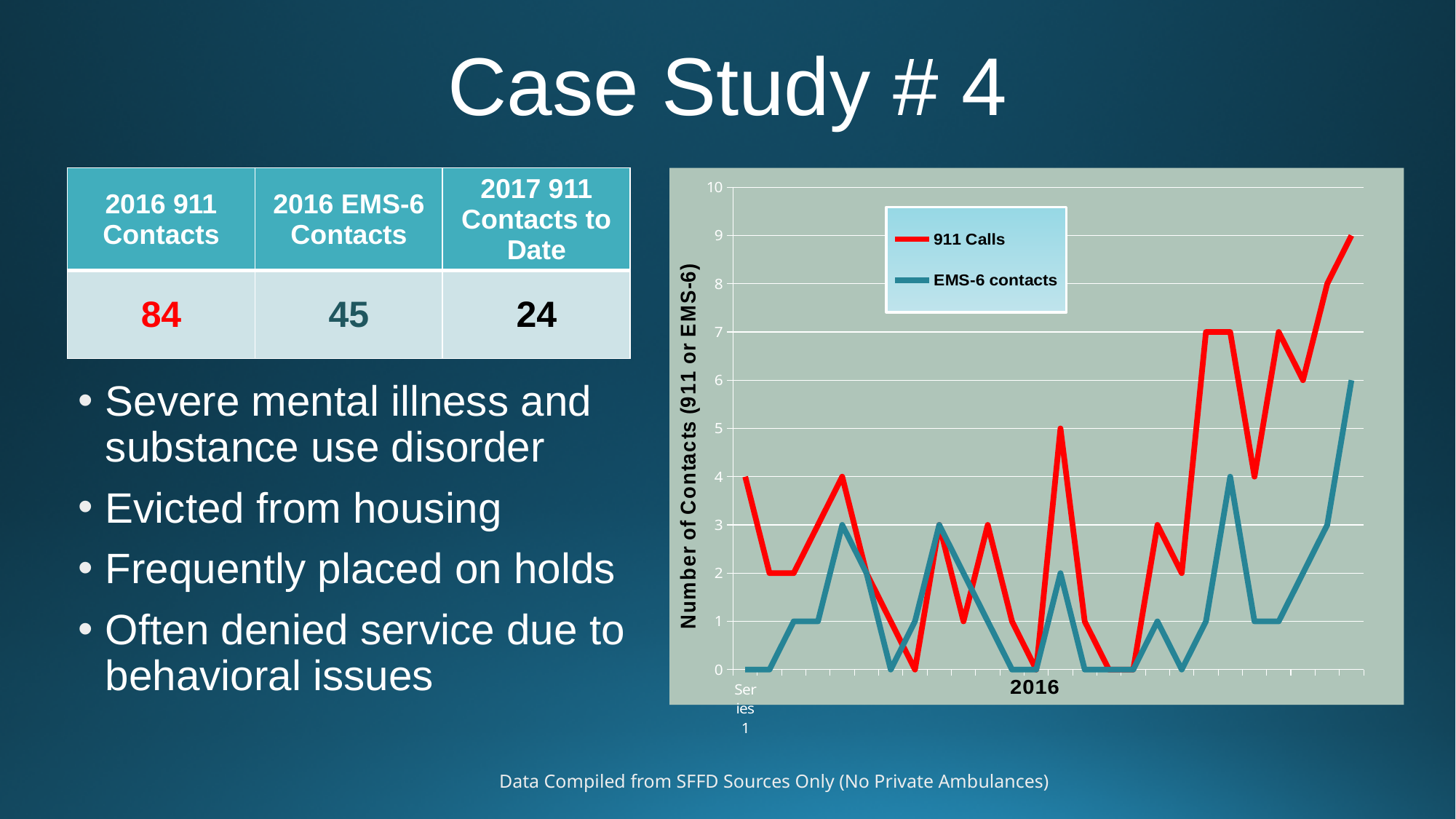
What colour is the 911 Calls line in the chart? red Which series reaches the highest value on the chart? 911 Calls What is the highest value reached by the 911 Calls line? 9 Do the 911 Calls values rise or fall toward the right-hand end of the chart? rise What kind of chart is shown on the slide? line chart What are the two series named in the chart legend? 911 Calls and EMS-6 contacts How many series does the chart legend list? 2 What is the highest value shown on the chart's vertical axis? 10 What is the title of the chart's vertical axis? Number of Contacts (911 or EMS-6) What is the highest value reached by the EMS-6 contacts line? 6 At the right-hand end of the chart, which series has the higher value, 911 Calls or EMS-6 contacts? 911 Calls Is the final value of the 911 Calls line greater or less than 8? greater